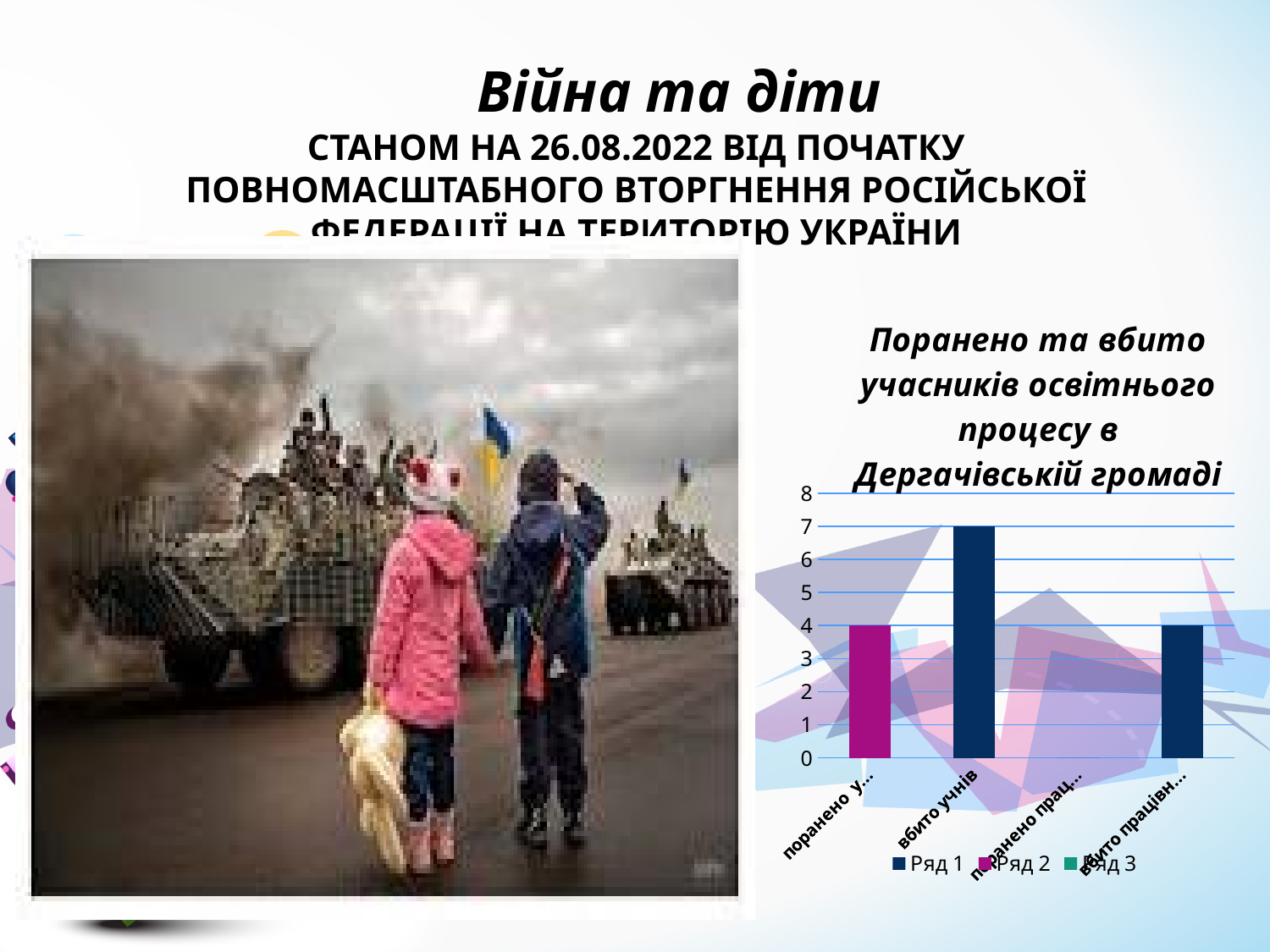
Which category has the highest bar? вбито учнів What kind of chart is shown on the slide? bar chart Is the value for "вбито учнів" greater or less than 5? greater What is the value of the last (rightmost) bar? 4 What is the value for "вбито учнів"? 7 How many series does the legend list? 3 What is the highest value shown on the vertical axis? 8 What is the value of the first (leftmost) bar? 4 How many categories are shown on the x axis? 4 What is the title of the chart? Поранено та вбито учасників освітнього процесу в Дергачівській громаді What is the difference between the value for "вбито учнів" and the value of the first bar? 3 Which is larger: the value for "вбито учнів" or the value of the rightmost bar? вбито учнів